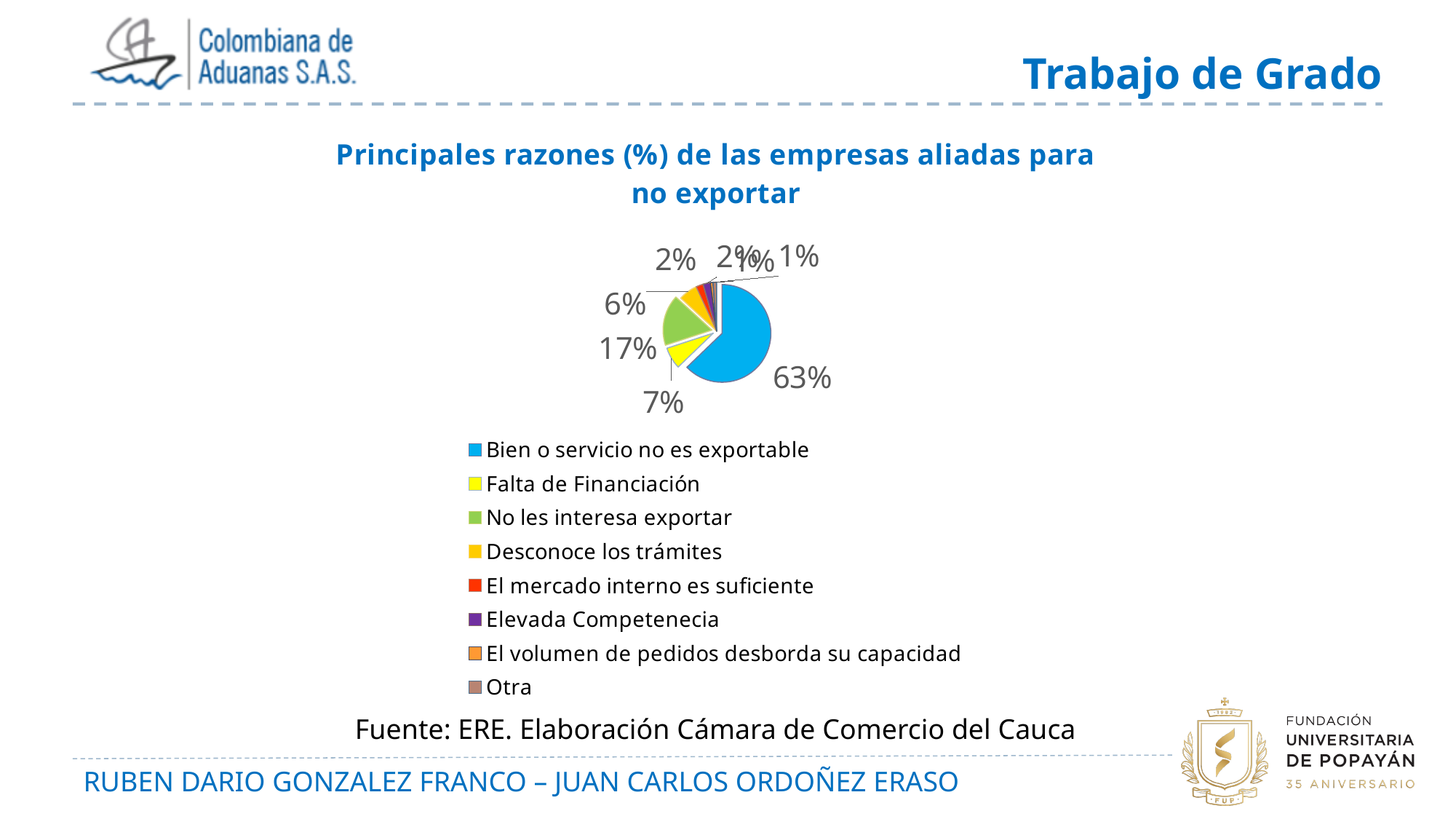
Which is larger: the share for 'Falta de Financiación' or for 'No les interesa exportar'? No les interesa exportar What is the title of the chart? Principales razones (%) de las empresas aliadas para no exportar What percentage of the pie corresponds to 'No les interesa exportar'? 17% What colour is the slice for 'Bien o servicio no es exportable'? Blue How many categories does the legend of the pie chart list? 8 What percentage of the pie corresponds to 'Bien o servicio no es exportable'? 63% What type of chart is shown on the slide? Pie chart What percentage of the pie corresponds to 'Desconoce los trámites'? 6% Which reason has the largest share of the pie? Bien o servicio no es exportable What percentage of the pie corresponds to 'Falta de Financiación'? 7% What is the difference in percentage points between 'No les interesa exportar' and 'Falta de Financiación'? 10 What is the difference in percentage points between 'Bien o servicio no es exportable' and 'No les interesa exportar'? 46